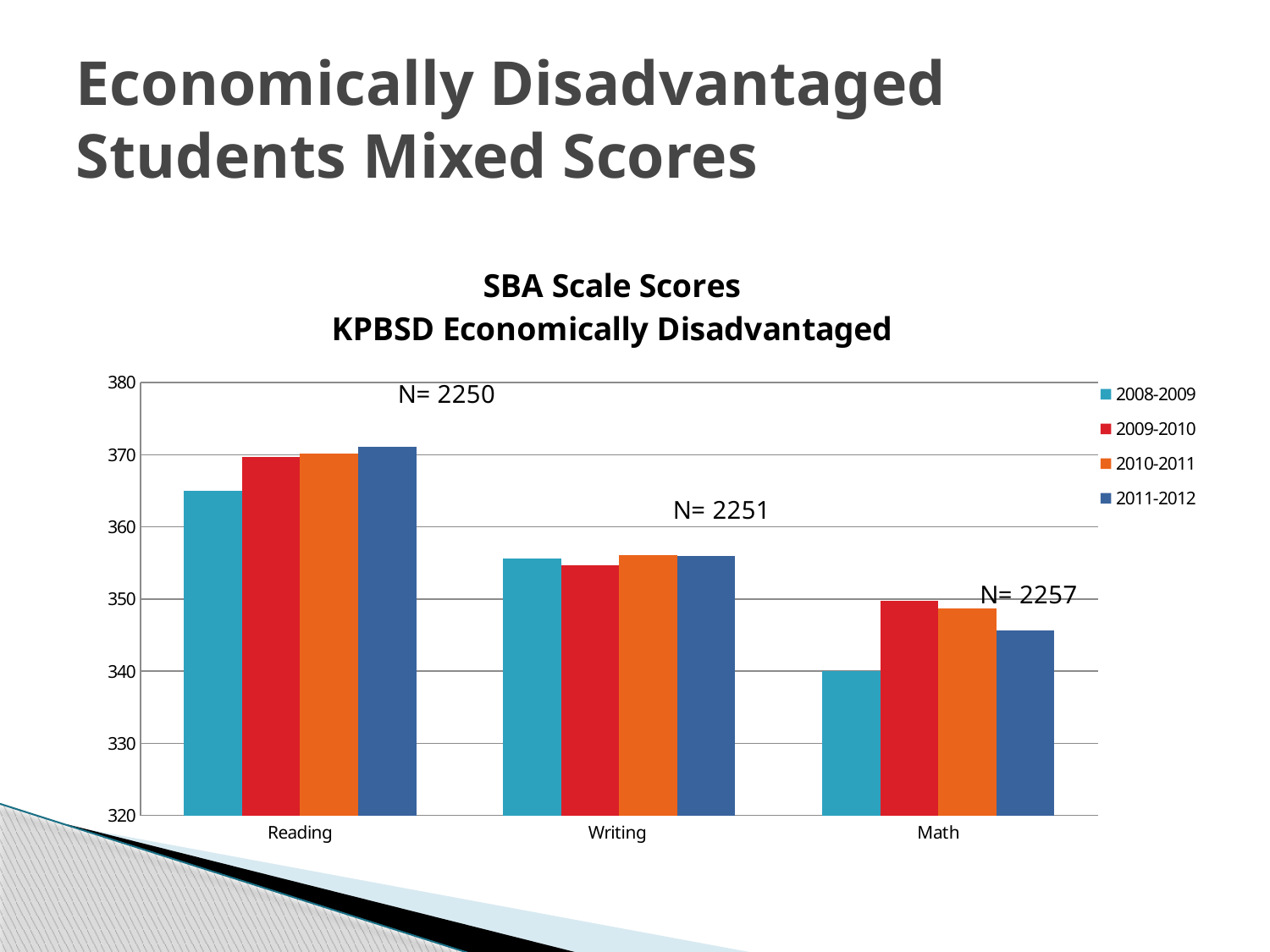
Is the Writing score for 2008-2009 greater or less than 350? greater How many subject categories are shown on the x axis? 3 Is the Reading score for 2008-2009 greater or less than 360? greater For Math, which is larger: the 2008-2009 score or the 2009-2010 score? 2009-2010 For Reading, which school year has the highest scale score? 2011-2012 Is the Math score for 2011-2012 greater or less than 350? less What N value is shown above the Math bars? N= 2257 How many series does the legend list? 4 For Math, which school year has the lowest scale score? 2008-2009 What kind of chart is shown on the slide? bar chart For the 2011-2012 series, do the scores rise or fall moving from Reading to Writing to Math? fall For Reading, which is larger: the 2008-2009 score or the 2011-2012 score? 2011-2012